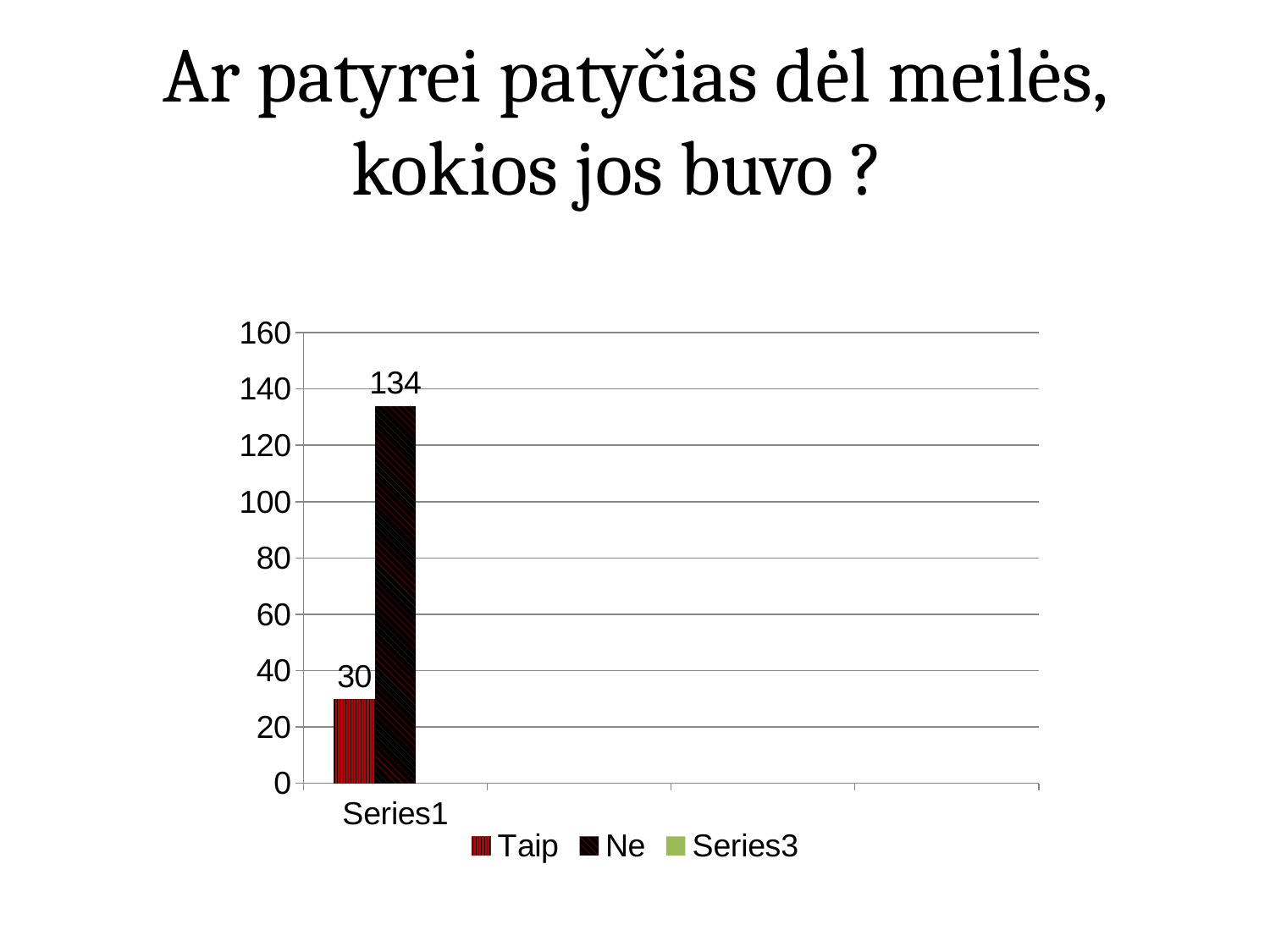
What is the value for Taip? 30 Which is larger, the value for Taip or the value for Ne? Ne Which series has the lowest plotted value? Taip What is the highest value shown on the vertical axis? 160 Which series has the highest value, Taip or Ne? Ne What kind of chart is shown on the slide? bar chart What is the value for Ne? 134 Is the value for Taip greater or less than 40? less Is the value for Ne greater or less than 120? greater How many series does the legend list? 3 What is the difference between the values for Ne and Taip? 104 What is the label of the category on the x axis? Series1